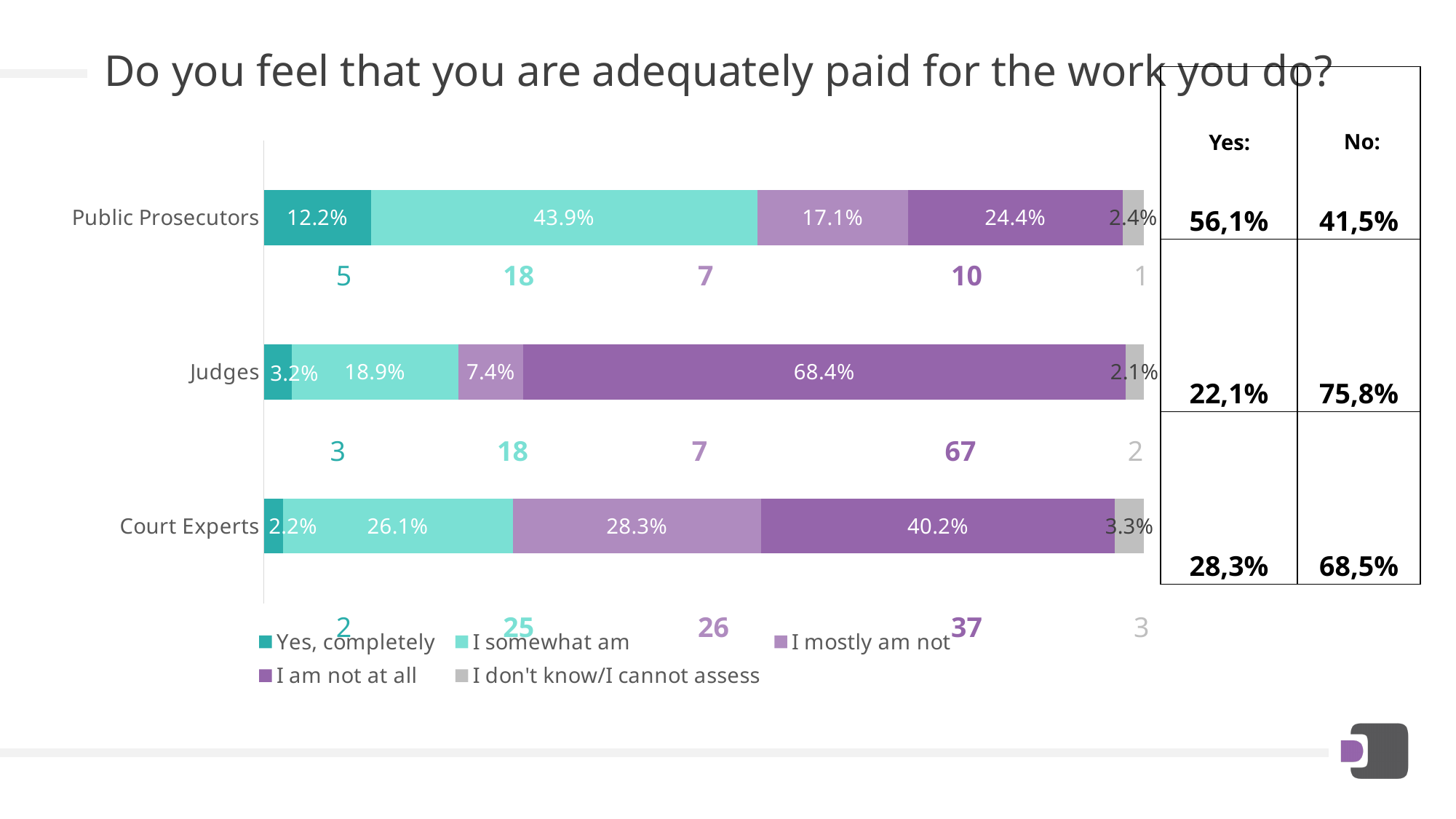
What percentage of Court Experts answered "I mostly am not"? 28.3% What is the difference in percentage points between the "I am not at all" share for Judges and for Court Experts? 28.2 percentage points How many Judges answered "I am not at all" (the count shown below the bar)? 67 Which group has the highest share of "I am not at all" responses? Judges What kind of chart is shown on the slide? Stacked bar chart Using the counts shown below the bar, what is the total number of Public Prosecutors who responded? 41 How many groups (categories) are shown in the chart? 3 For Court Experts, which is larger: the "I somewhat am" share or the "I mostly am not" share? I mostly am not What percentage of Judges answered "I am not at all"? 68.4% What percentage of Public Prosecutors answered "I somewhat am"? 43.9% How many response options does the legend list? 5 Which group has the lowest share of "Yes, completely" responses? Court Experts